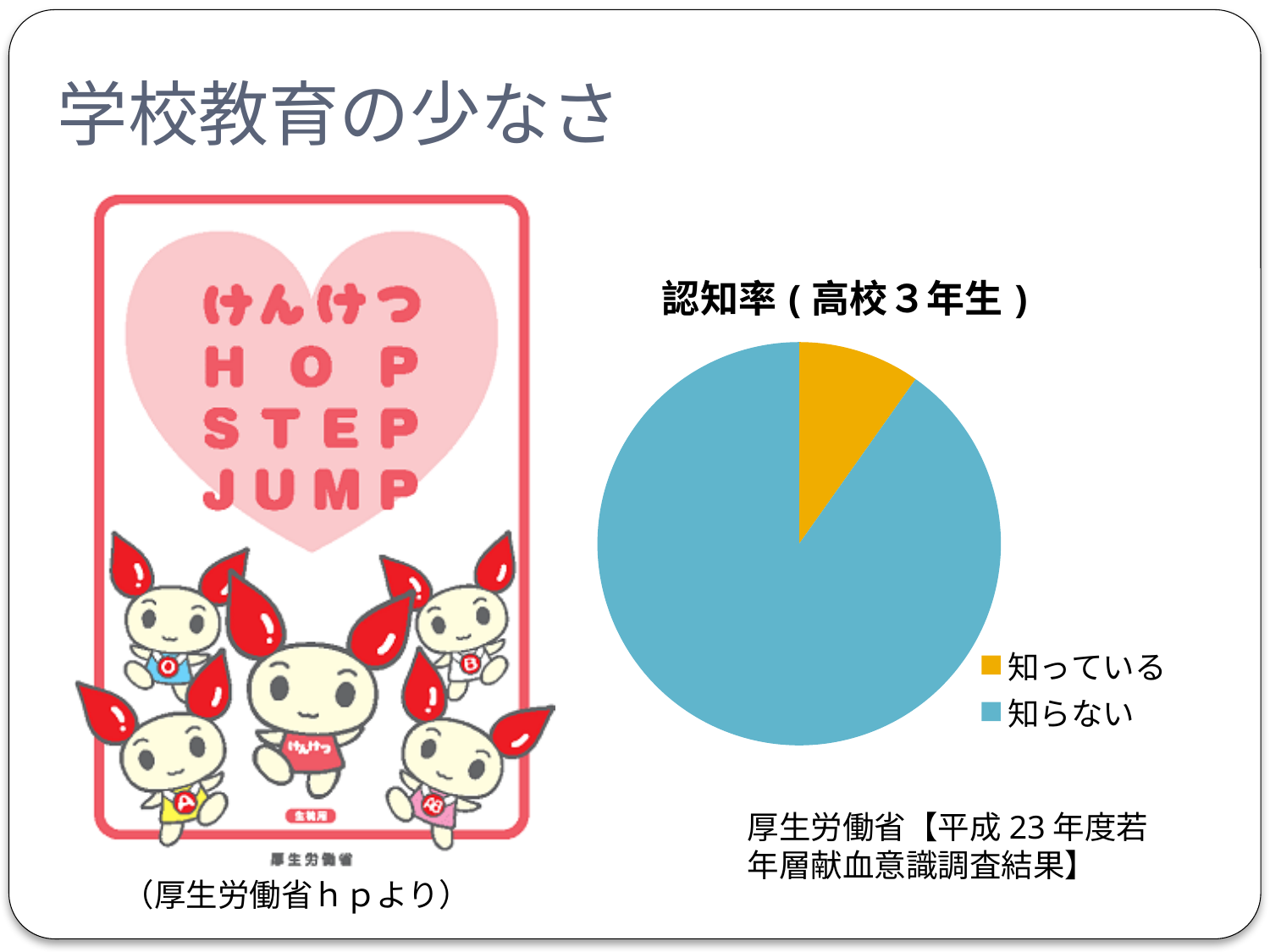
What colour is the 知っている slice in the pie chart? orange Which is larger in the pie chart, 知っている or 知らない? 知らない How many slices does the pie chart have? 2 What kind of chart is shown on the slide? pie chart What is the title of the pie chart? 認知率(高校3年生) How many entries does the legend of the pie chart list? 2 Which slice of the pie chart is the largest? 知らない Which slice of the pie chart is the smallest? 知っている Does the 知らない slice take up more or less than half of the pie chart? more